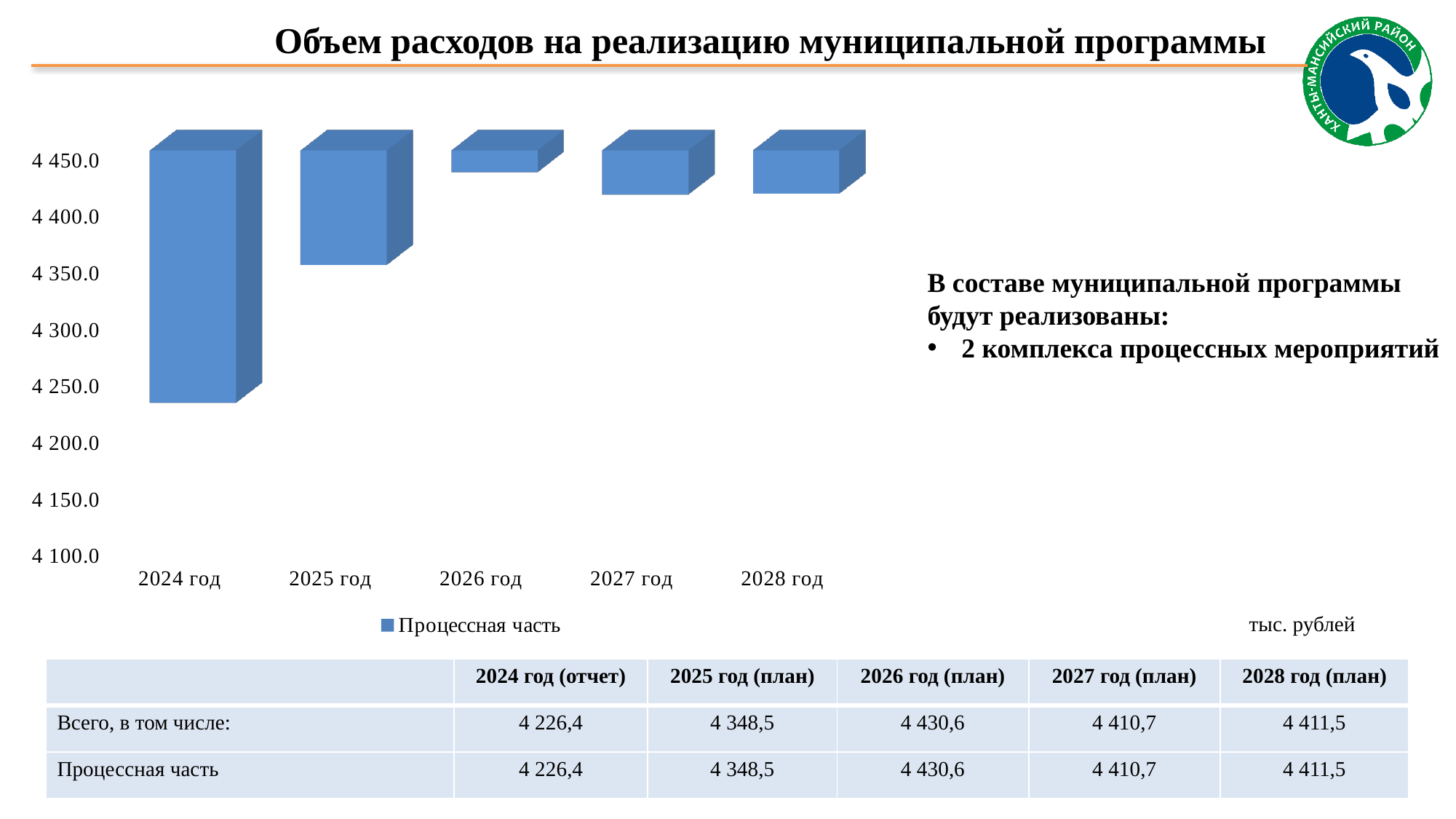
What is the name of the series in the chart legend? Процессная часть What kind of chart is shown on the slide? bar chart What is the difference between the values for 2025 год and 2024 год? 122,1 Is the value for 2024 год greater or less than 4 300? less What is the value for 2028 год in the chart? 4 411,5 What is the value for 2026 год in the chart? 4 430,6 What is the value for 2024 год in the chart? 4 226,4 Which is larger, the value for 2025 год or the value for 2026 год? 2026 год How many years are shown on the x axis of the chart? 5 Which year has the lowest value in the chart? 2024 год How many series does the chart legend list? 1 Which year has the highest value in the chart? 2026 год